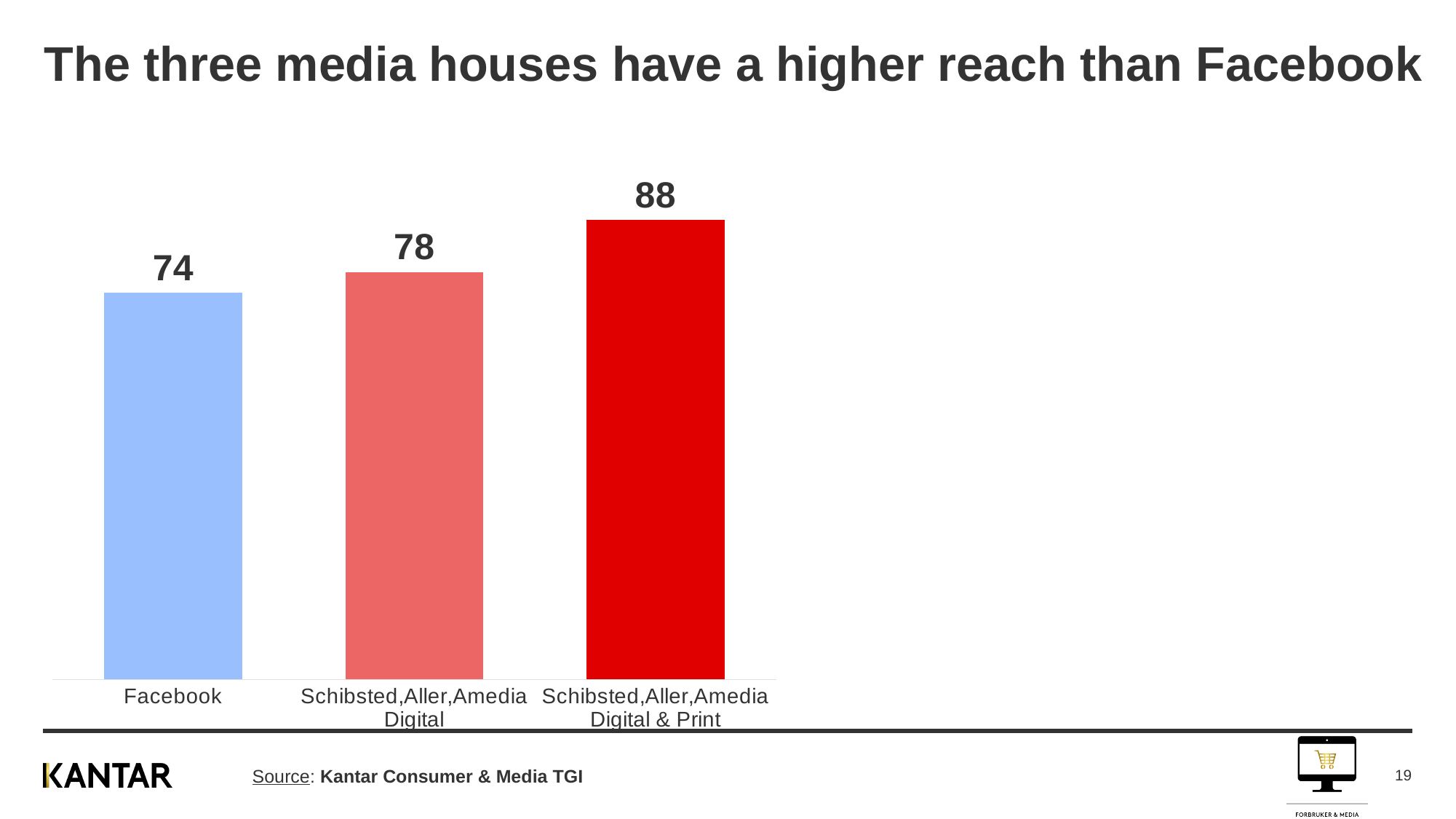
What is the difference between the values for Schibsted,Aller,Amedia Digital and Facebook? 4 Which is larger, the value for Facebook or the value for Schibsted,Aller,Amedia Digital? Schibsted,Aller,Amedia Digital How many categories are shown in the chart? 3 What is the value for Schibsted,Aller,Amedia Digital & Print? 88 What kind of chart is shown on the slide? Bar chart Do the values rise or fall from left to right across the categories? Rise What colour is the bar for Facebook? Light blue What is the value for Schibsted,Aller,Amedia Digital? 78 Which category has the highest value? Schibsted,Aller,Amedia Digital & Print Which category has the lowest value? Facebook What is the value for Facebook? 74 What is the difference between the values for Schibsted,Aller,Amedia Digital & Print and Facebook? 14